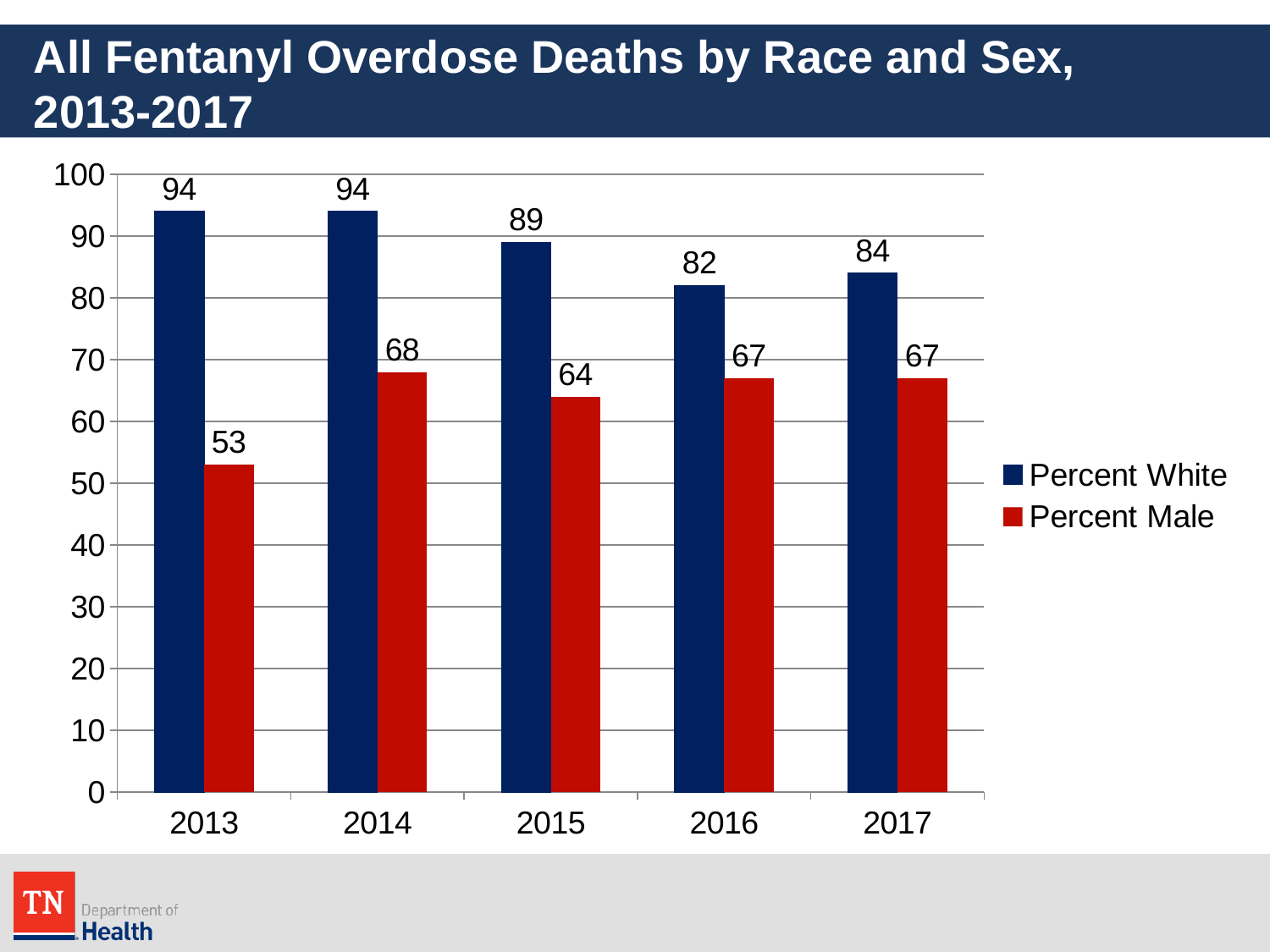
Is the Percent White value for 2017 larger than the Percent Male value for 2017? Yes What is the Percent Male value for 2014? 68 Which year has the highest Percent Male value? 2014 How many series does the legend list? 2 What kind of chart is shown on the slide? Bar chart What is the Percent White value for 2015? 89 Which year has the lowest Percent White value? 2016 What is the difference between Percent White and Percent Male in 2013? 41 What is the title of the chart? All Fentanyl Overdose Deaths by Race and Sex, 2013-2017 How many years are shown on the x axis? 5 What is the Percent Male value for 2013? 53 Which year has the lowest Percent Male value? 2013